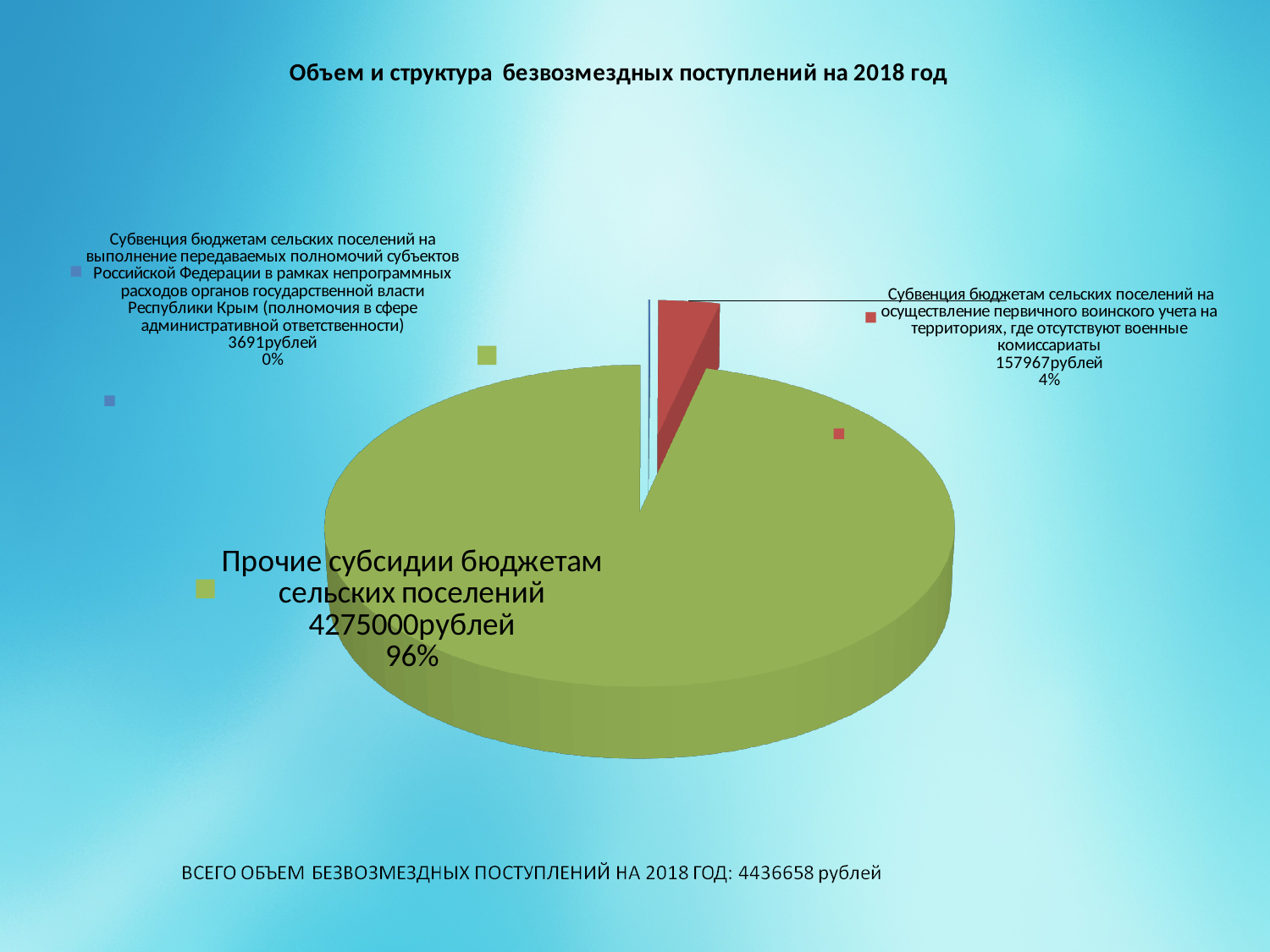
What is the value shown for "Прочие субсидии бюджетам сельских поселений"? 4275000рублей What kind of chart is shown on the slide? pie chart How many slices does the pie chart have? 3 Which is larger: the value for "Прочие субсидии бюджетам сельских поселений" or the value for the subvention for primary military registration ("воинского учета")? Прочие субсидии бюджетам сельских поселений What is the title of the chart? Объем и структура безвозмездных поступлений на 2018 год What share of the pie does "Прочие субсидии бюджетам сельских поселений" represent? 96% What is the total volume of gratuitous receipts for 2018 stated on the slide? 4436658 рублей Which category has the largest slice of the pie? Прочие субсидии бюджетам сельских поселений What is the value shown for the subvention for administrative responsibility powers ("полномочия в сфере административной ответственности")? 3691рублей What percentage is shown for the subvention for primary military registration ("воинского учета")? 4% Which category has the smallest slice of the pie? Субвенция бюджетам сельских поселений на выполнение передаваемых полномочий субъектов Российской Федерации (полномочия в сфере административной ответственности) What is the value shown for the subvention for primary military registration ("Субвенция бюджетам сельских поселений на осуществление первичного воинского учета")? 157967рублей